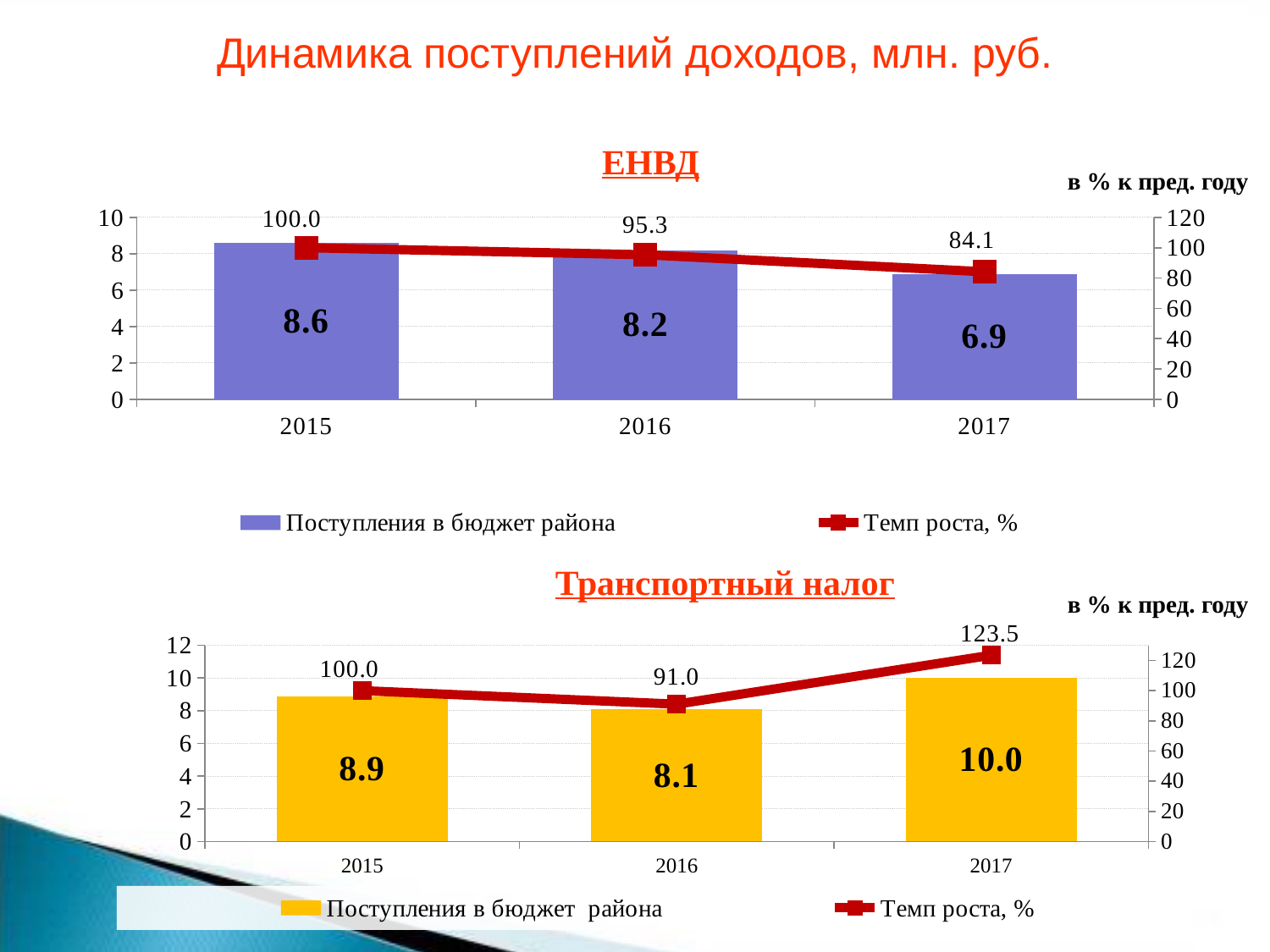
In the Транспортный налог chart, what is the value of Поступления в бюджет района for 2017? 10.0 In the ЕНВД chart, what is the Темп роста, % value for 2017? 84.1 In the Транспортный налог chart, what is the difference between Поступления в бюджет района in 2017 and 2016? 1.9 In the ЕНВД chart, what is the value of Поступления в бюджет района for 2016? 8.2 In the Транспортный налог chart, which year has the highest Темп роста, %? 2017 In the ЕНВД chart, which year has the lowest Поступления в бюджет района? 2017 In the Транспортный налог chart, what is the Темп роста, % value for 2016? 91.0 How many series does the legend of the Транспортный налог chart list? 2 How many years are shown on the x axis of the ЕНВД chart? 3 In the ЕНВД chart, do the Поступления в бюджет района values rise or fall from 2015 to 2017? fall In the Транспортный налог chart, is Поступления в бюджет района larger in 2015 or in 2016? 2015 In the ЕНВД chart, what is the difference between Поступления в бюджет района in 2015 and 2017? 1.7